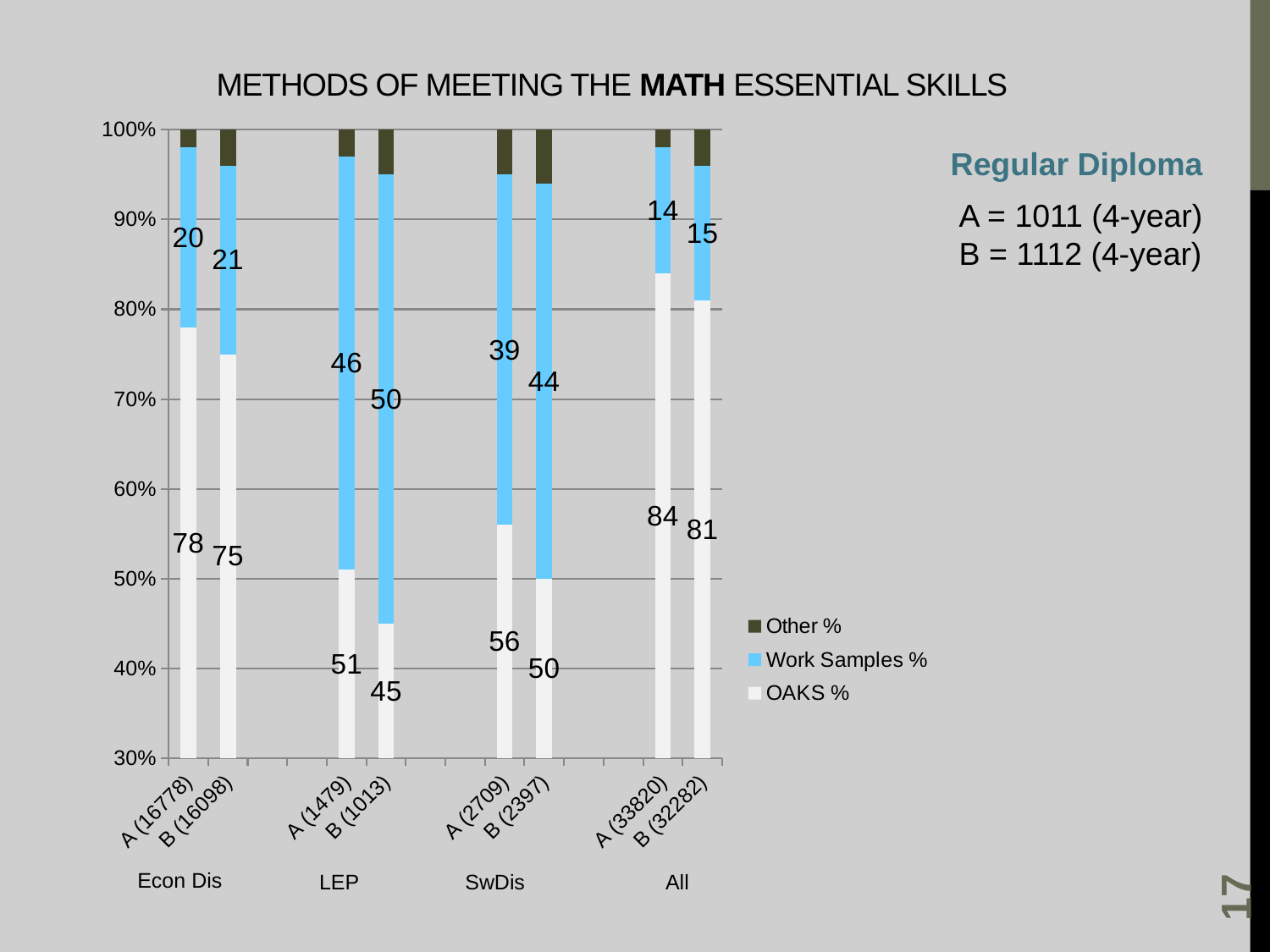
How many series does the legend list? 3 Which series is shown in light blue in the legend? Work Samples % What is the Work Samples % value for A (33820) in the All group? 14 What is the Work Samples % value for B (1013) in the LEP group? 50 Which is larger, the Work Samples % for A (2709) or for B (2397) in the SwDis group? B (2397) What is the OAKS % value for A (16778) in the Econ Dis group? 78 Which bar has the lowest OAKS % value? B (1013) How many bars are plotted in the chart? 8 Which bar has the highest OAKS % value? A (33820) What type of chart is shown on the slide? Stacked bar chart What is the OAKS % value for B (2397) in the SwDis group? 50 What is the difference between the OAKS % values for A (16778) and B (16098) in the Econ Dis group? 3